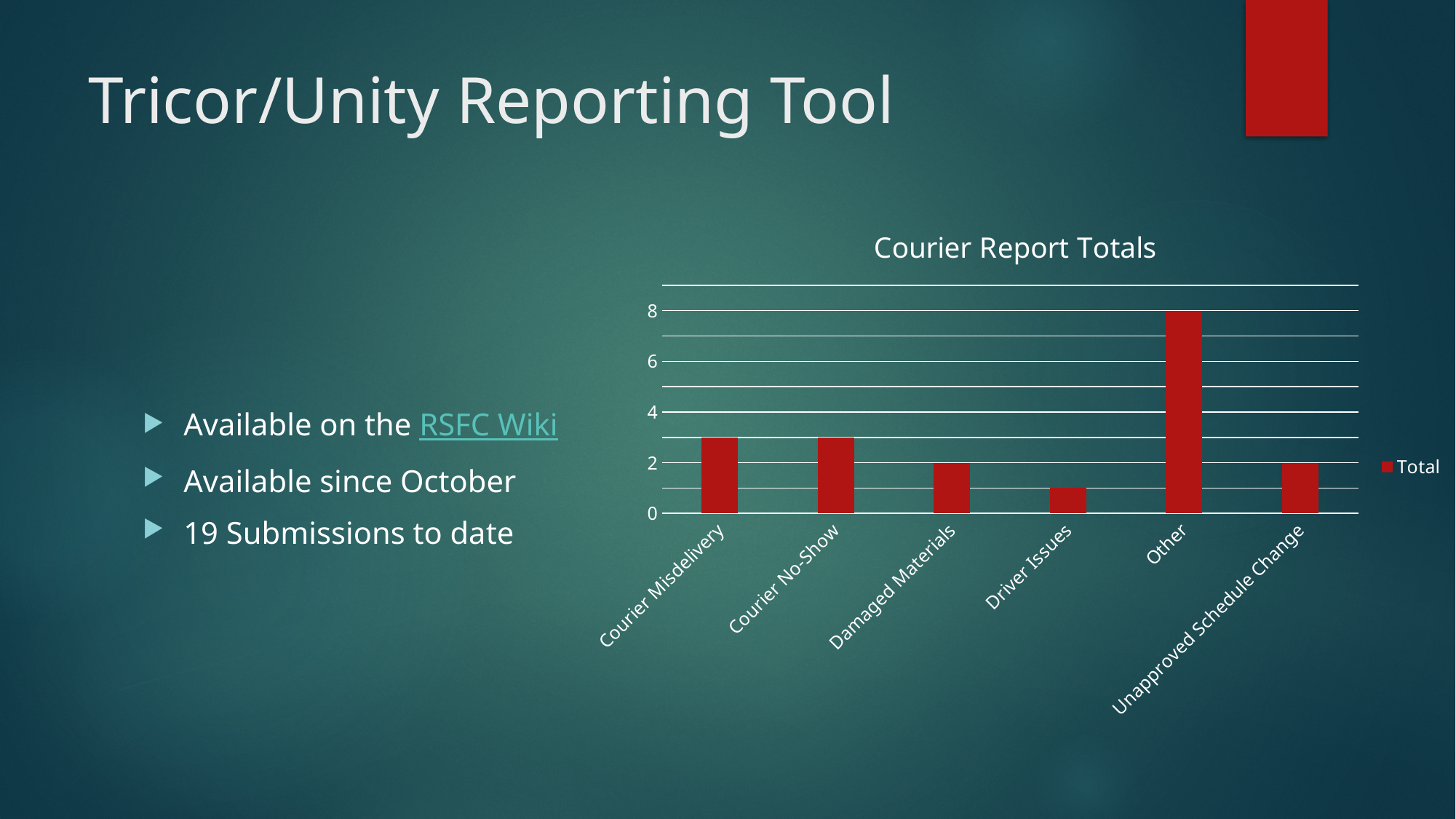
Which is larger, the value for Courier No-Show or the value for Damaged Materials? Courier No-Show Which category has the highest value in the chart? Other How many series does the chart legend list? 1 What is the difference between the values for Other and Damaged Materials? 6 What is the value for Other? 8 What is the title of the chart? Courier Report Totals How many categories are shown on the x axis of the chart? 6 What is the value for Unapproved Schedule Change? 2 Which category has the lowest value in the chart? Driver Issues Is the value for Courier Misdelivery greater or less than 2? greater What is the value for Damaged Materials? 2 What kind of chart is shown on the slide? bar chart